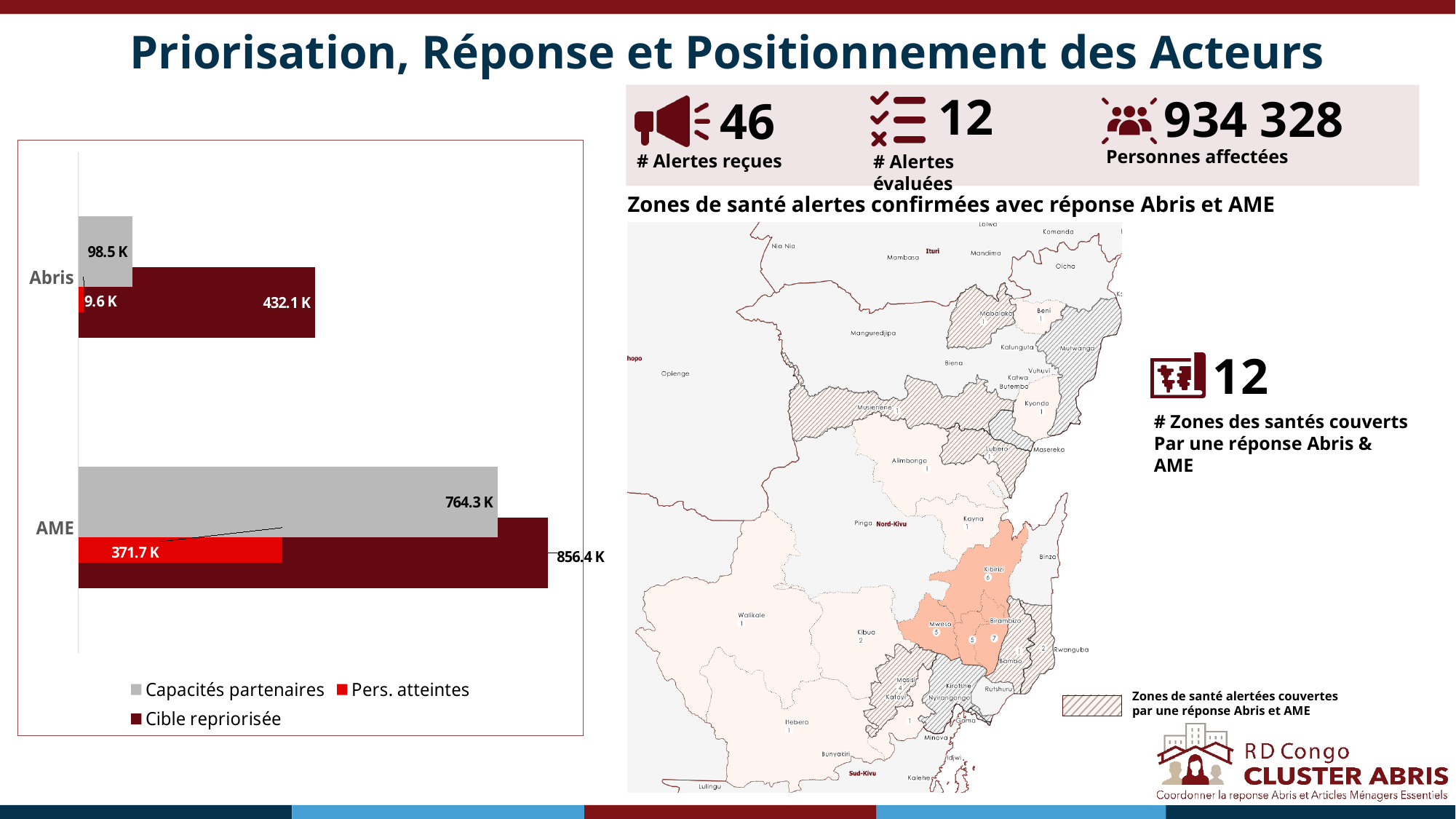
What is the difference between Cible repriorisée and Capacités partenaires for Abris? 333.6 K Which series has the lowest value for Abris? Pers. atteintes What is the value of Pers. atteintes for AME? 371.7 K Which category has the higher Cible repriorisée value, Abris or AME? AME What type of chart is shown on the left of the slide? Bar chart What is the difference between Cible repriorisée and Capacités partenaires for AME? 92.1 K What is the value of Cible repriorisée for AME? 856.4 K What is the value of Capacités partenaires for AME? 764.3 K What is the value of Pers. atteintes for Abris? 9.6 K How many categories are shown on the bar chart? 2 What is the value of Capacités partenaires for Abris? 98.5 K How many series does the chart legend list? 3